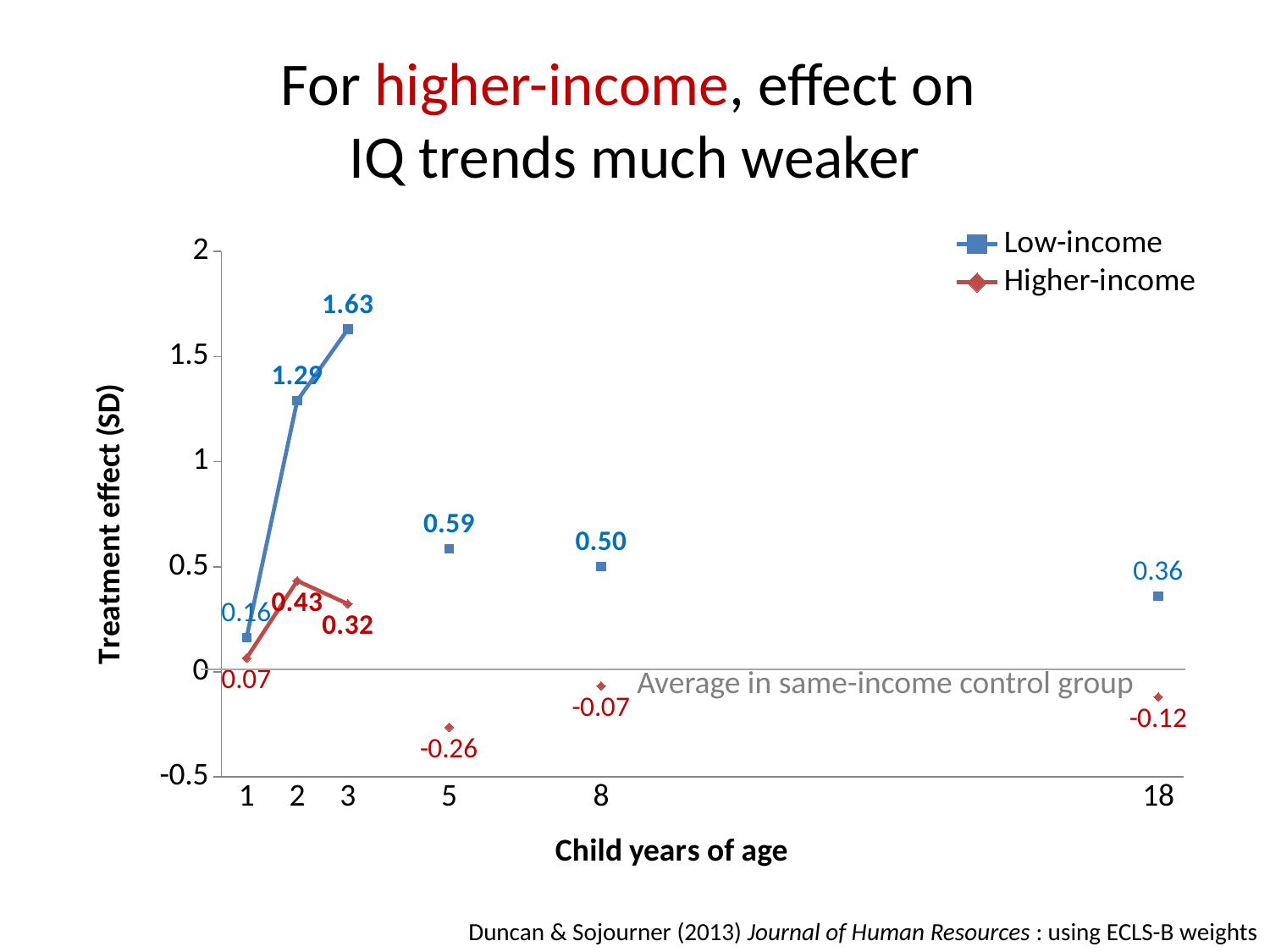
How many child ages are plotted on the x axis? 6 Which series has the larger treatment effect at age 8, Low-income or Higher-income? Low-income What kind of chart is shown on the slide? Line chart How many series does the legend list? 2 What is the treatment effect for the Low-income series at age 18? 0.36 What is the label of the y axis? Treatment effect (SD) What is the treatment effect for the Higher-income series at age 2? 0.43 What is the treatment effect for the Low-income series at age 3? 1.63 What is the difference between the Low-income and Higher-income treatment effects at age 3? 1.31 What is the treatment effect for the Higher-income series at age 5? -0.26 At which child age is the Low-income treatment effect highest? 3 At which child age is the Higher-income treatment effect lowest? 5